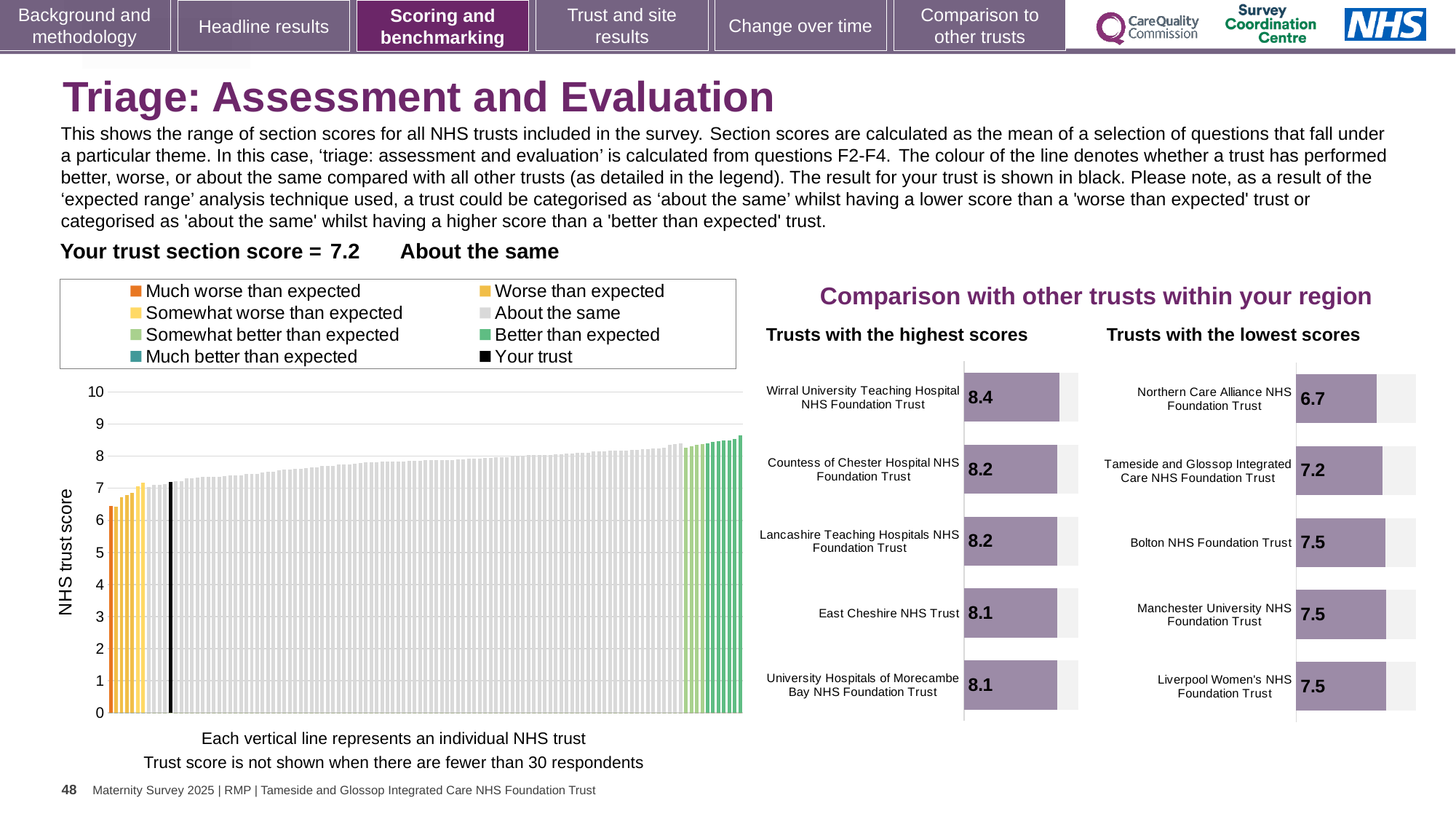
In the 'Trusts with the lowest scores' chart, what is the difference between the scores of Tameside and Glossop Integrated Care NHS Foundation Trust and Northern Care Alliance NHS Foundation Trust? 0.5 In the 'Trusts with the highest scores' chart, which trust has the highest score? Wirral University Teaching Hospital NHS Foundation Trust What kind of chart is the NHS trust score chart on the left of the slide? Bar chart How many trusts are shown in the 'Trusts with the lowest scores' chart? 5 In the 'Trusts with the lowest scores' chart, which trust has the lowest score? Northern Care Alliance NHS Foundation Trust How many entries does the legend of the NHS trust score chart on the left list? 8 In the 'Trusts with the lowest scores' chart, what is the score for Bolton NHS Foundation Trust? 7.5 In the 'Trusts with the lowest scores' chart, what is the score for Northern Care Alliance NHS Foundation Trust? 6.7 In the NHS trust score chart on the left, is the tallest bar greater or less than 9? less In the 'Trusts with the highest scores' chart, which has a higher score: Countess of Chester Hospital NHS Foundation Trust or University Hospitals of Morecambe Bay NHS Foundation Trust? Countess of Chester Hospital NHS Foundation Trust In the 'Trusts with the highest scores' chart, what is the difference between the scores of Wirral University Teaching Hospital NHS Foundation Trust and East Cheshire NHS Trust? 0.3 In the 'Trusts with the highest scores' chart, what is the score for Wirral University Teaching Hospital NHS Foundation Trust? 8.4